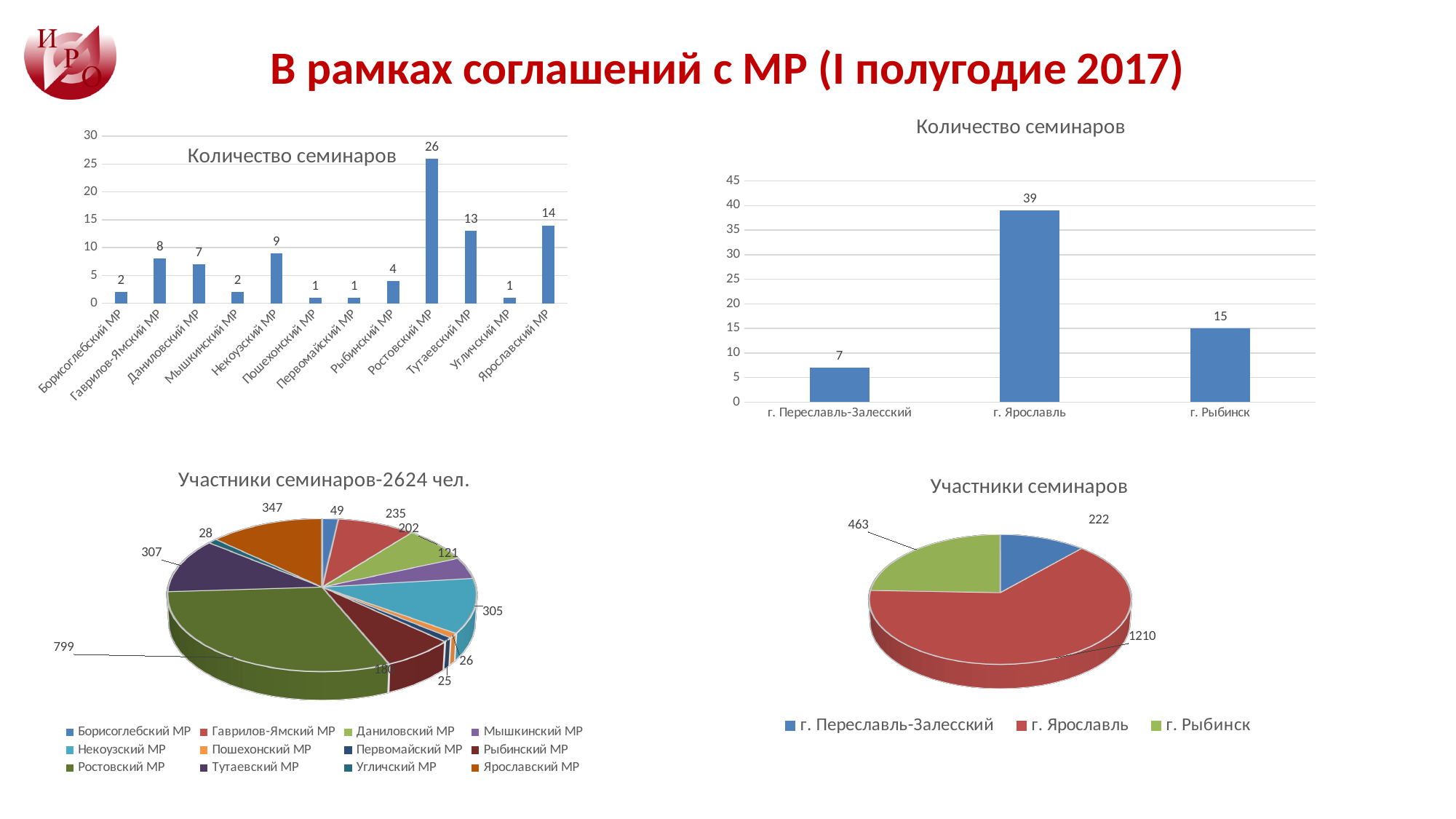
In the bottom-left pie chart 'Участники семинаров-2624 чел.', what is the value for Ярославский МР? 347 In the top-left bar chart 'Количество семинаров', what is the value for Ростовский МР? 26 In the top-left bar chart 'Количество семинаров', which district has the highest value? Ростовский МР In the top-left bar chart, which is larger: the value for Тутаевский МР or for Ярославский МР? Ярославский МР In the bottom-left pie chart 'Участники семинаров-2624 чел.', which district has the largest slice? Ростовский МР In the top-right bar chart 'Количество семинаров', what is the value for г. Ярославль? 39 How many entries does the legend of the bottom-right pie chart 'Участники семинаров' list? 3 In the top-right bar chart, which city has the lowest value? г. Переславль-Залесский In the bottom-right pie chart 'Участники семинаров', what is the value for г. Ярославль? 1210 What kind of chart is the top-right chart 'Количество семинаров'? bar chart In the top-right bar chart, what is the difference between the values for г. Ярославль and г. Рыбинск? 24 How many districts are shown in the top-left bar chart 'Количество семинаров'? 12